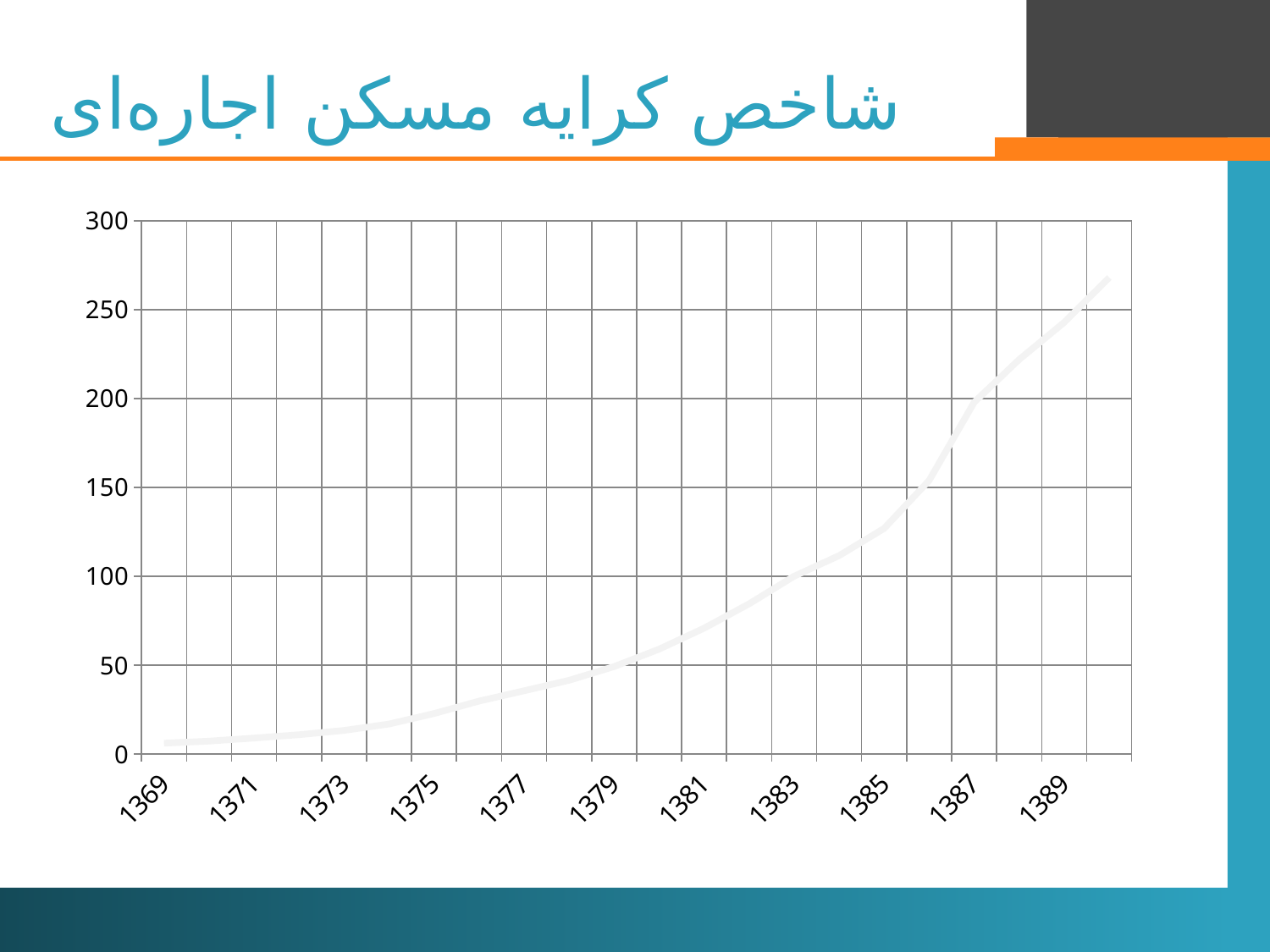
Is the value for 1385 greater or less than 100? greater Does the rental housing index rise or fall from 1369 to 1389? rise Is the value for 1373 greater or less than 50? less Is the value for 1377 greater or less than 50? less Which year has the larger value, 1375 or 1385? 1385 What kind of chart is shown on the slide? line chart How many year labels are shown on the x axis? 11 Which of the labeled years has the lowest value? 1369 Which of the labeled years has the highest value? 1389